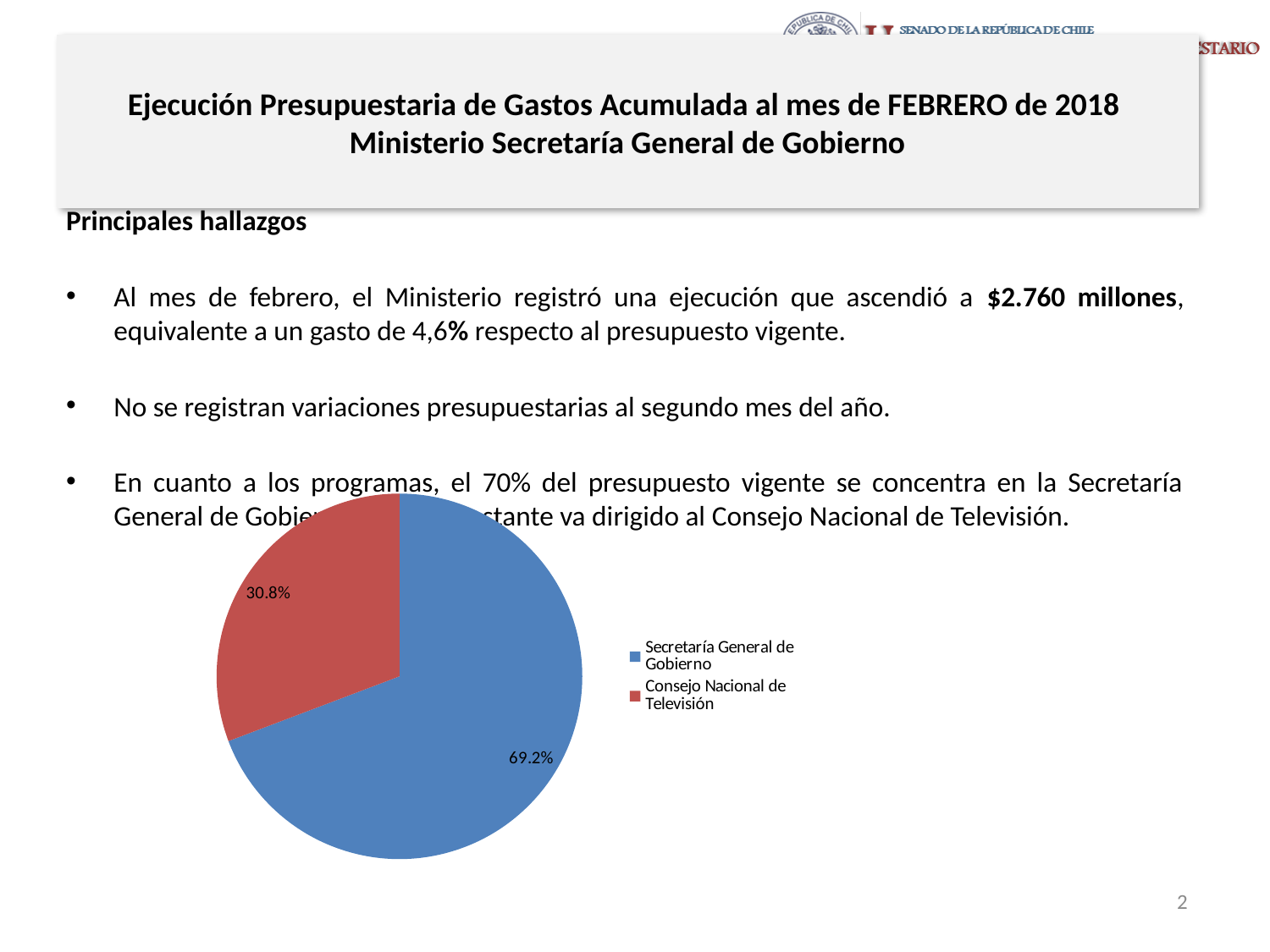
How many slices does the pie chart have? 2 Which slice of the pie is the largest? Secretaría General de Gobierno What share of the pie does Consejo Nacional de Televisión hold? 30.8% How many entries does the legend of the pie chart list? 2 Which slice of the pie is the smallest? Consejo Nacional de Televisión What share of the pie does Secretaría General de Gobierno hold? 69.2% What kind of chart is shown on the slide? pie chart What colour is the Consejo Nacional de Televisión slice? red What is the difference in percentage points between the Secretaría General de Gobierno slice and the Consejo Nacional de Televisión slice? 38.4 What colour is the Secretaría General de Gobierno slice? blue Which is larger: the Consejo Nacional de Televisión slice or the Secretaría General de Gobierno slice? Secretaría General de Gobierno